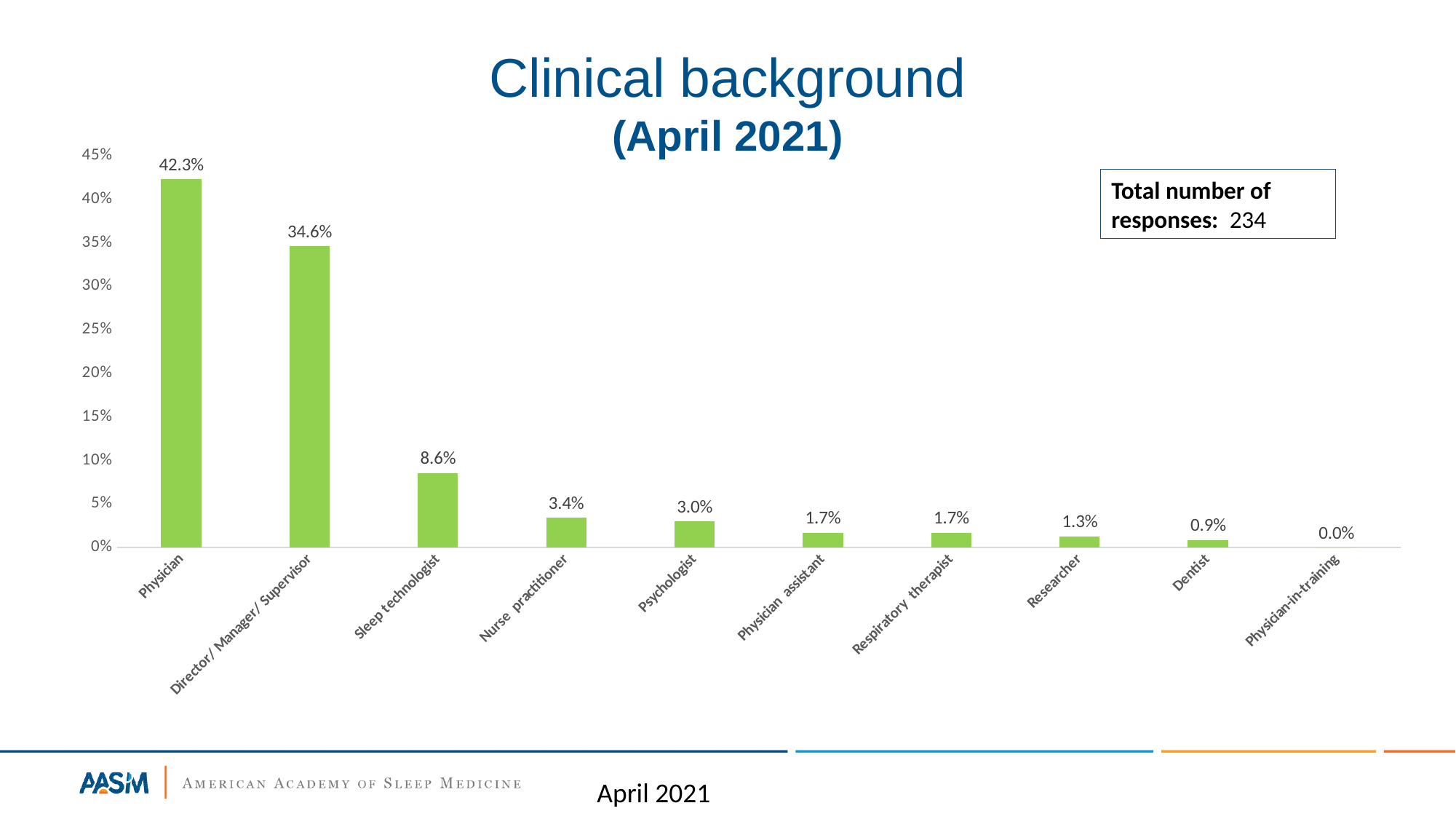
What is the value for Dentist? 0.9% Which is larger, the value for Nurse practitioner or the value for Psychologist? Nurse practitioner What is the total number of responses stated on the slide? 234 Which clinical background has the highest percentage? Physician Is the value for Sleep technologist greater or less than 10%? less What percentage is shown for Sleep technologist? 8.6% How many clinical background categories are shown on the x axis? 10 What percentage of respondents have a Physician clinical background? 42.3% What kind of chart is shown on the slide? Bar chart Which clinical background has the lowest percentage? Physician-in-training What is the value shown for Director/ Manager/ Supervisor? 34.6% What is the difference between the Physician and Director/ Manager/ Supervisor percentages? 7.7%